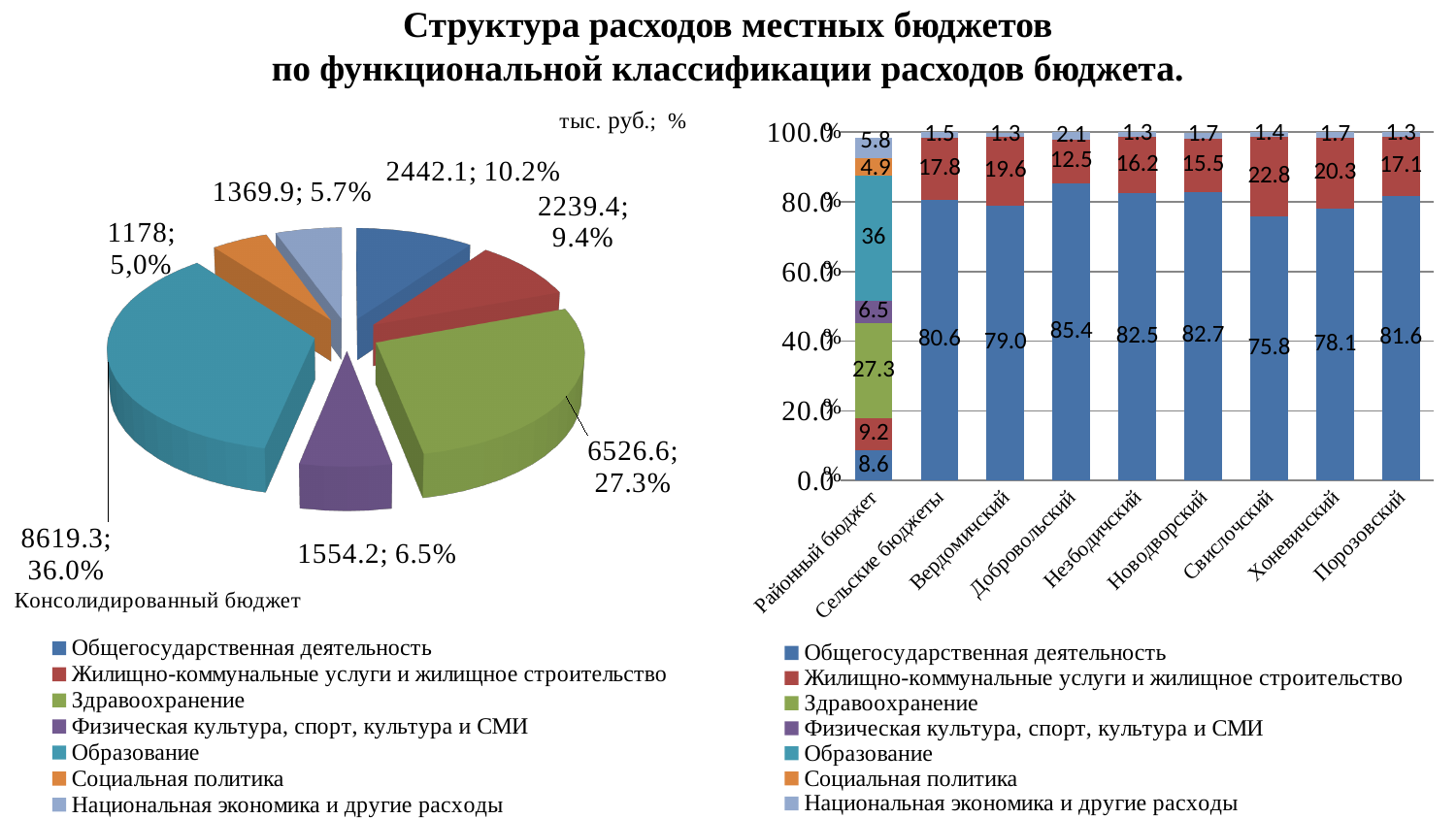
In the pie chart on the left, what value is shown for Образование? 8619.3; 36.0% In the stacked bar chart on the right, what is the value of Жилищно-коммунальные услуги и жилищное строительство for Свислочский? 22.8 In the pie chart on the left, what percentage share does Здравоохранение have? 27.3% What kind of chart is the chart on the right? Stacked bar chart In the stacked bar chart on the right, what is the value of Общегосударственная деятельность for Добровольский? 85.4 In the stacked bar chart on the right, what is the difference between the Общегосударственная деятельность values for Добровольский and Свислочский? 9.6 In the stacked bar chart on the right, how many categories are shown on the x axis? 9 In the pie chart on the left, which category has the largest share? Образование In the stacked bar chart on the right, which is larger: the Жилищно-коммунальные услуги value for Вердомичский or for Порозовский? Вердомичский How many categories does the legend of the pie chart on the left list? 7 In the pie chart on the left, which category has the smallest share? Социальная политика In the stacked bar chart on the right, which category has the highest value for Общегосударственная деятельность? Добровольский